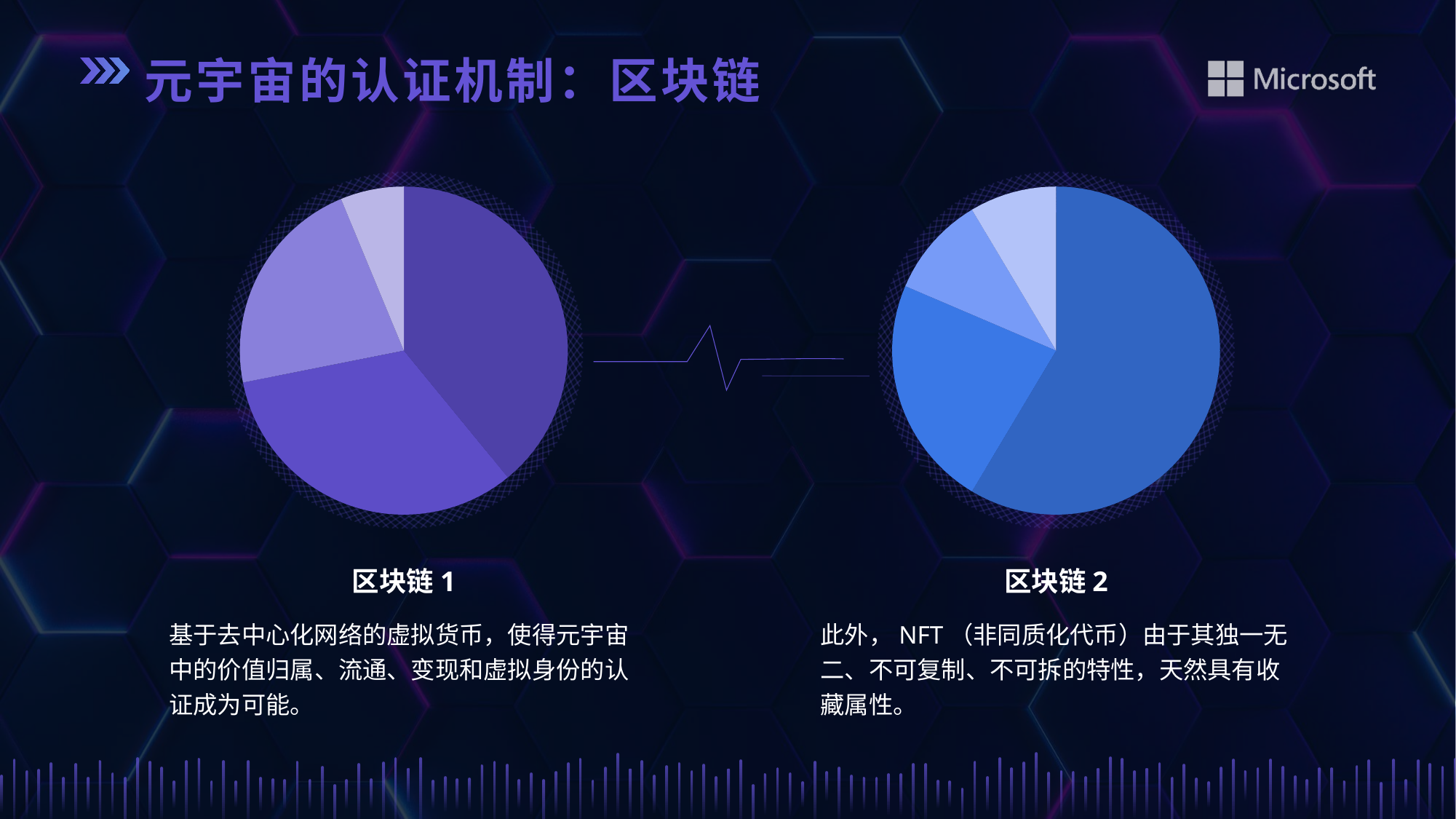
In the pie chart labelled 区块链 2, which slice is the smallest? the lightest blue slice In the pie chart labelled 区块链 1, which slice is the largest: the darkest purple slice or the lightest purple slice? the darkest purple slice What colour scheme is used for the right pie chart? shades of blue How many pie charts are on the slide? 2 In the pie chart labelled 区块链 1, which slice is the smallest? the lightest purple slice How many slices does the pie chart labelled 区块链 2 have? 4 In the pie chart labelled 区块链 2, which is larger: the darkest blue slice or the lightest blue slice? the darkest blue slice What label appears below the left pie chart? 区块链 1 What kind of chart is shown under the label 区块链 2? pie chart How many slices does the pie chart labelled 区块链 1 have? 4 What kind of chart is shown under the label 区块链 1? pie chart In the pie chart labelled 区块链 2, which slice is the largest? the darkest blue slice